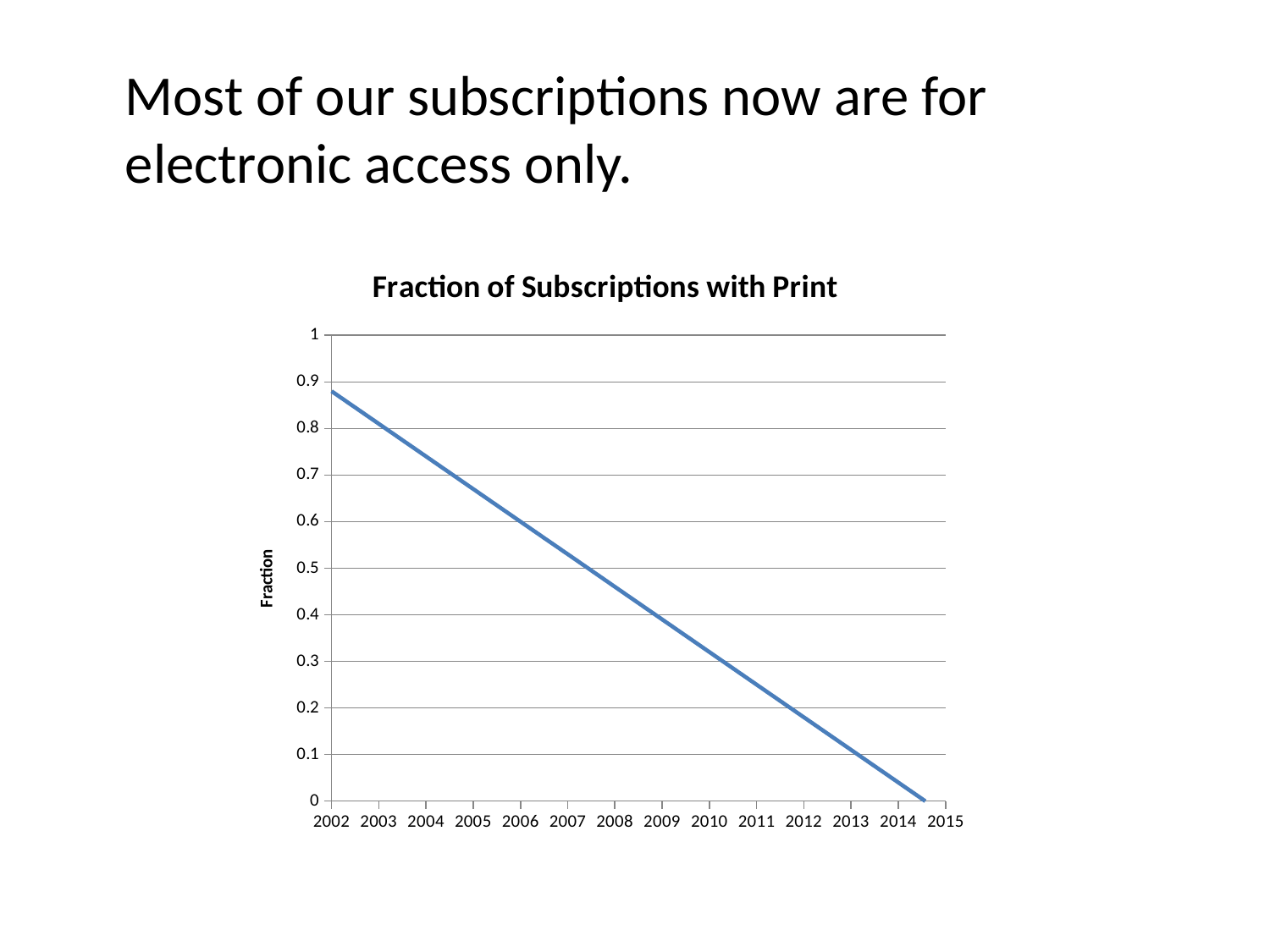
Is the value for 2010 greater or less than 0.4? less Is the value for 2006 greater or less than 0.5? greater In which year is the fraction of subscriptions with print highest? 2002 Is the value for 2004 greater or less than 0.6? greater How many year labels are shown on the horizontal axis? 14 Which year has the larger fraction of subscriptions with print, 2004 or 2010? 2004 Does the fraction of subscriptions with print rise or fall from 2002 to 2015? fall What is the title of the chart? Fraction of Subscriptions with Print What is the label on the vertical axis of the chart? Fraction What kind of chart is shown on the slide? line chart